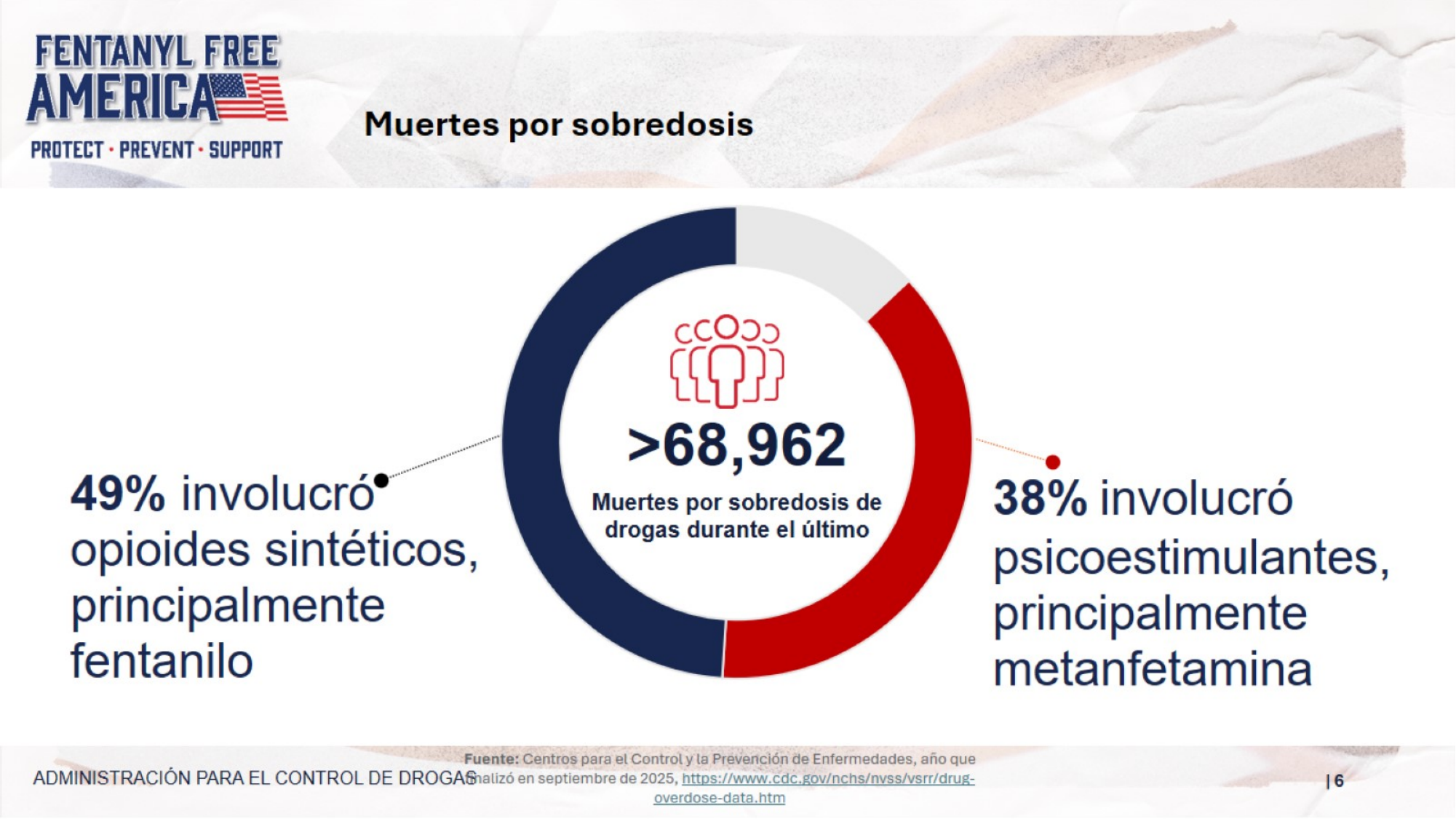
What is the difference in percentage points between the synthetic opioids share and the psychostimulants share? 11 percentage points What colour is the segment representing psychostimulants (38%)? Red What number of overdose deaths is shown in the center of the chart? >68,962 What colour is the segment representing synthetic opioids (49%)? Dark blue Which category has the larger share: synthetic opioids or psychostimulants? Synthetic opioids (49%) What kind of chart is shown on the slide? Pie chart (donut) How many percentage values are labeled on the chart? 2 Which labeled category has the lowest share in the chart? Psychostimulants, mainly methamphetamine What percentage of overdose deaths involved synthetic opioids, mainly fentanyl? 49% What percentage of overdose deaths involved psychostimulants, mainly methamphetamine? 38% Which labeled category has the highest share in the chart? Synthetic opioids, mainly fentanyl